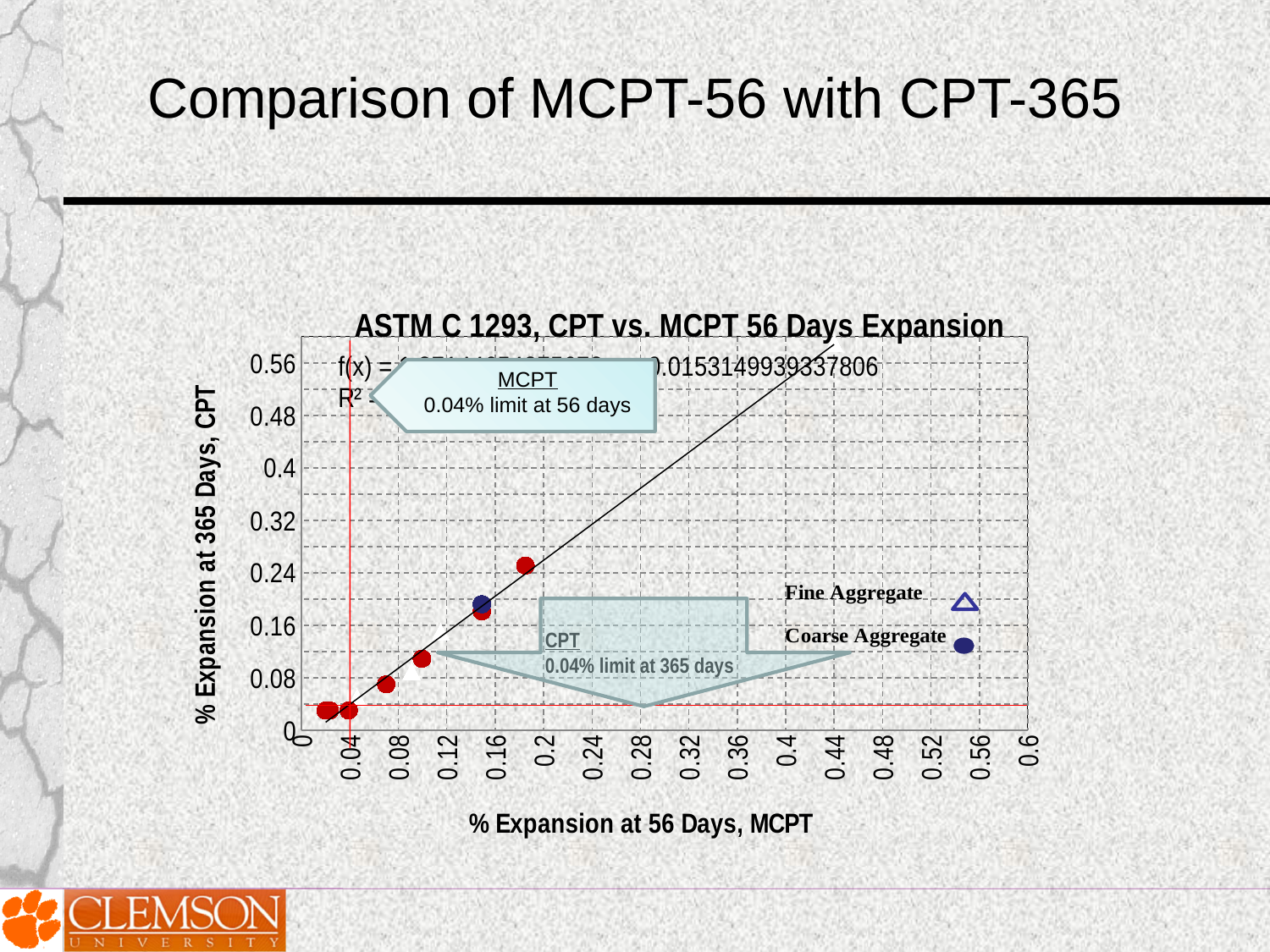
Is the x value (% Expansion at 56 Days, MCPT) of the rightmost data point greater or less than 0.24? less Which has the higher y value: the data point near x = 0.18 or the data point near x = 0.10? the point near x = 0.18 What kind of chart is shown on the slide? scatter chart What is the title of the chart? ASTM C 1293, CPT vs. MCPT 56 Days Expansion Is the y value (% Expansion at 365 Days, CPT) of the rightmost data point greater or less than 0.16? greater Do the plotted points rise or fall as the x-axis value (% Expansion at 56 Days, MCPT) increases? rise What two entries does the chart legend list? Fine Aggregate and Coarse Aggregate How many series does the legend list? 2 Is the y value (% Expansion at 365 Days, CPT) of the leftmost data points greater or less than 0.08? less